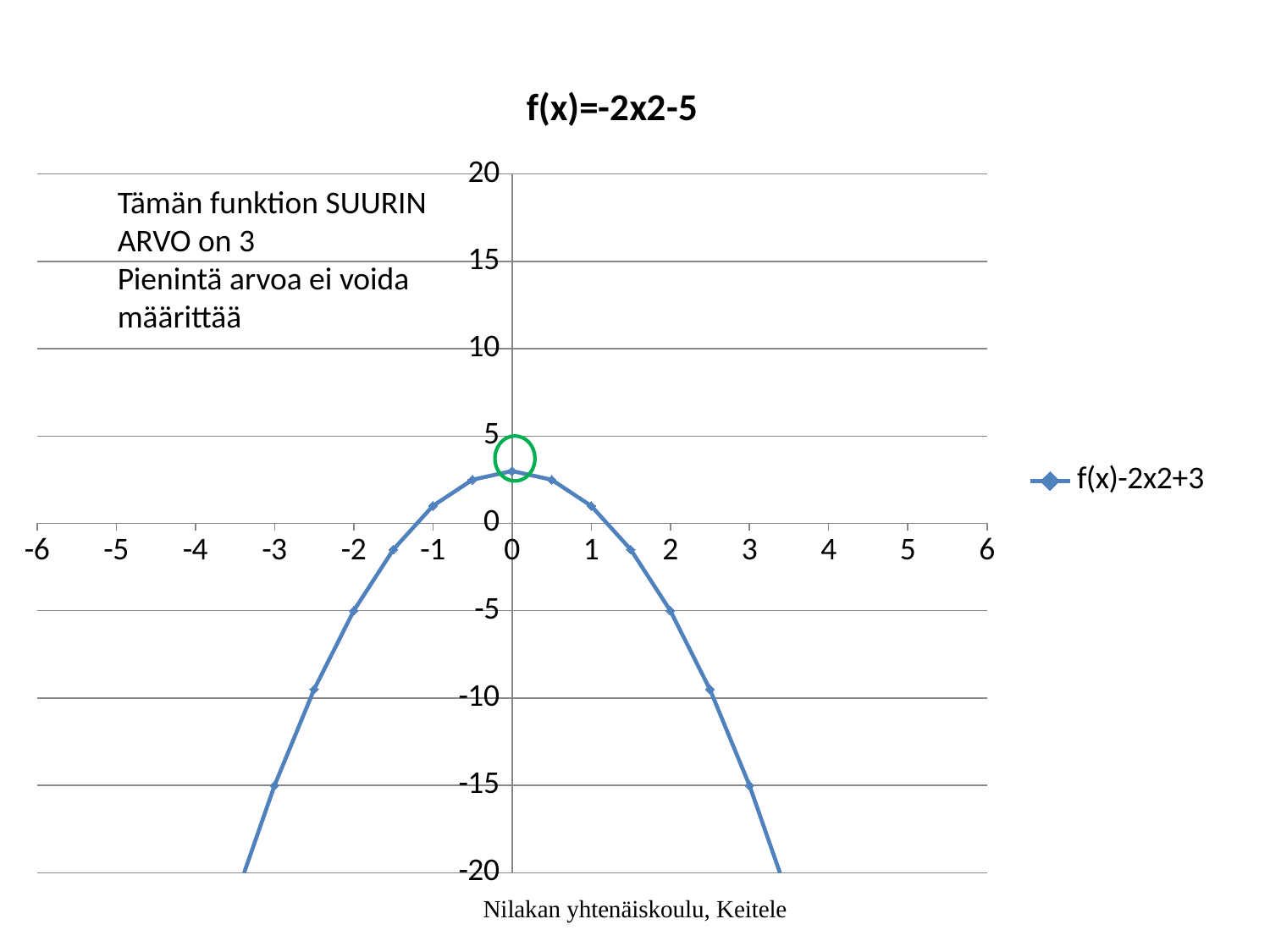
What is the legend entry for the plotted series? f(x)-2x2+3 What is the value of the function at x = 3? -15 How many series does the legend list? 1 What is the title of the chart? f(x)=-2x2-5 Is the value of the function at x = 2.5 greater or less than -5? less What is the difference between the function values at x = -2 and x = -3? 10 Do the values rise or fall as x increases from 0 to 3? fall What is the largest value of the function, as stated on the slide? 3 What kind of chart is shown on the slide? line chart At which x value does the plotted function reach its highest value? 0 What is the value of the function at x = -2? -5 Is the value of the function at x = -1 greater or less than 0? greater